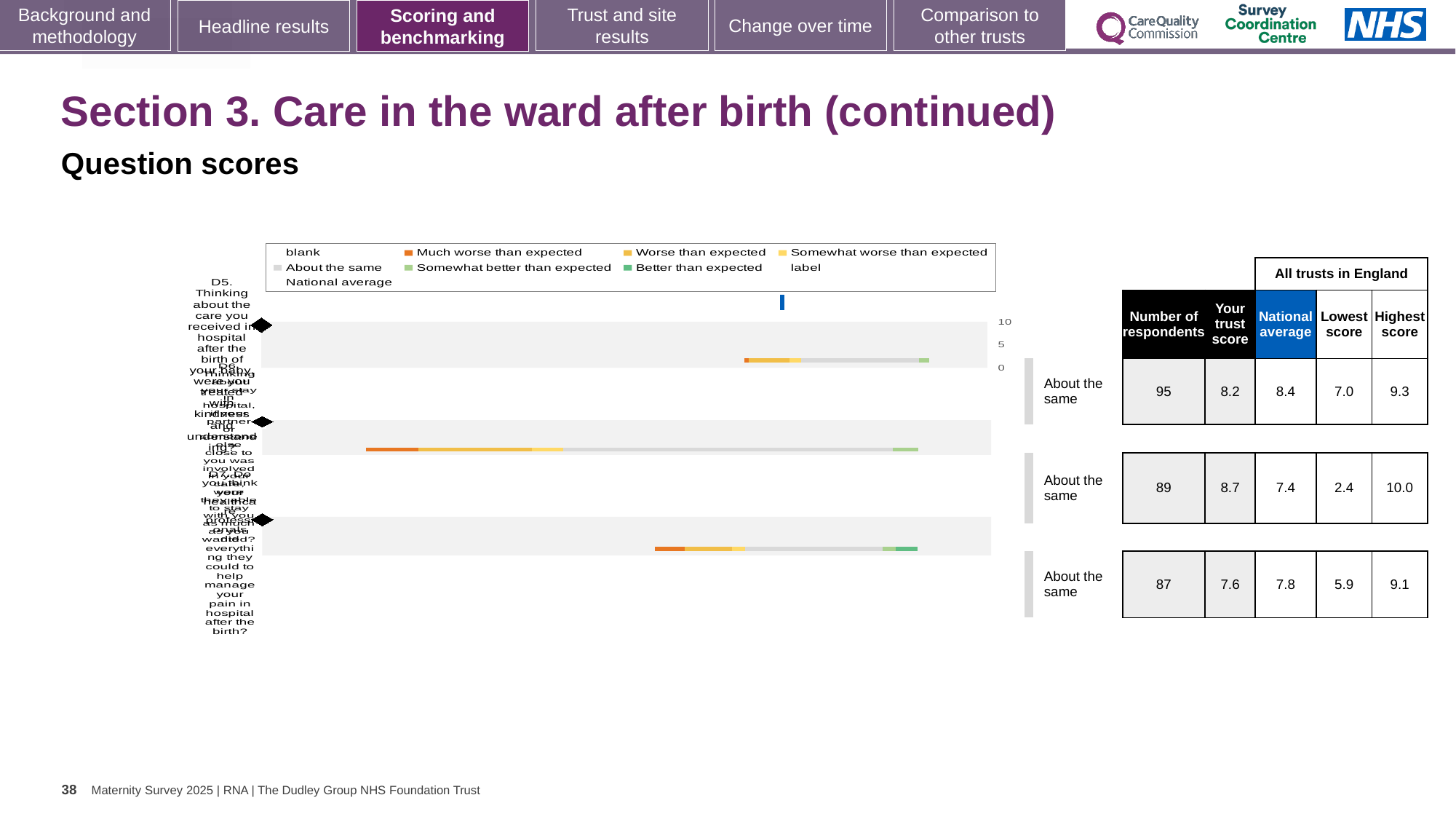
Which row has the lowest 'Lowest score' in the table? the second row (2.4) What is the National average for the second row of the table (89 respondents)? 7.4 What is the 'Your trust score' for the first row of the table (95 respondents)? 8.2 Which legend entry is shown in grey in the chart's legend? About the same Which row has the highest 'Your trust score' in the table? the second row (8.7) Which legend entry is shown in orange in the chart's legend? Much worse than expected What is the difference between the National average and Your trust score in the first row of the table? 0.2 What is the Highest score for the third row of the table (87 respondents)? 9.1 How many question rows (bars) does the chart show? 3 For the first row of the table, which is larger: Your trust score or the National average? National average What is the difference between the Highest score and Lowest score in the second row of the table? 7.6 What kind of chart is shown on the slide? bar chart